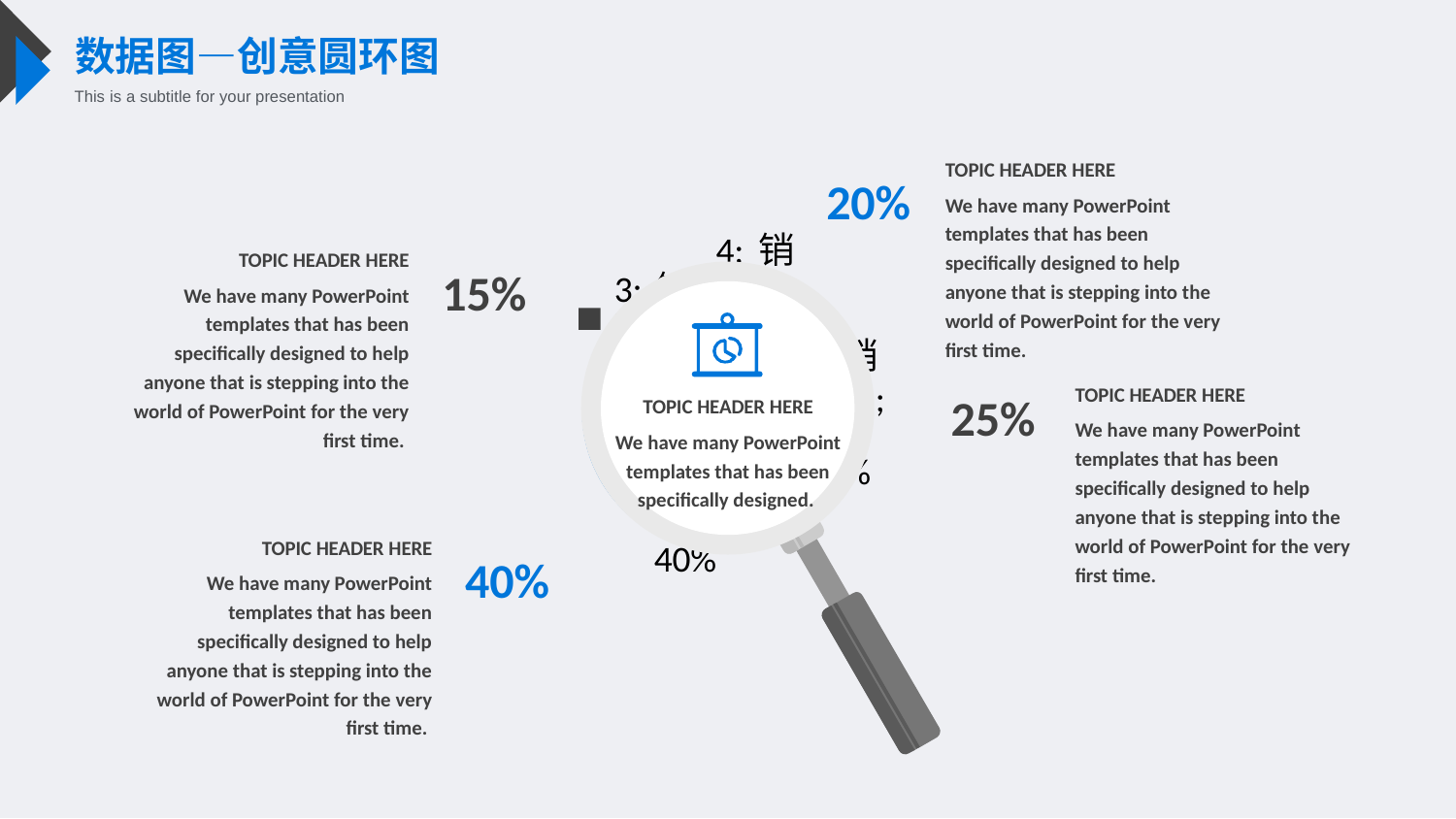
Which of the percentage values called out around the chart is the smallest? 15% Which is larger, the 25% callout on the right or the 20% callout at the top right? 25% What percentage value is printed as a data label near the bottom of the chart, just below the magnifying glass lens? 40% Which of the percentage values called out around the chart is the largest? 40% What do the four percentage callouts (15%, 20%, 25%, 40%) add up to? 100% What kind of chart is shown on the slide, according to the slide title and the ring shape visible behind the magnifying glass? donut chart How many percentage values are called out around the chart on the slide? 4 What is the title of the slide containing the chart? 数据图—创意圆环图 What is the difference between the largest callout value (40%) and the smallest callout value (15%)? 25%